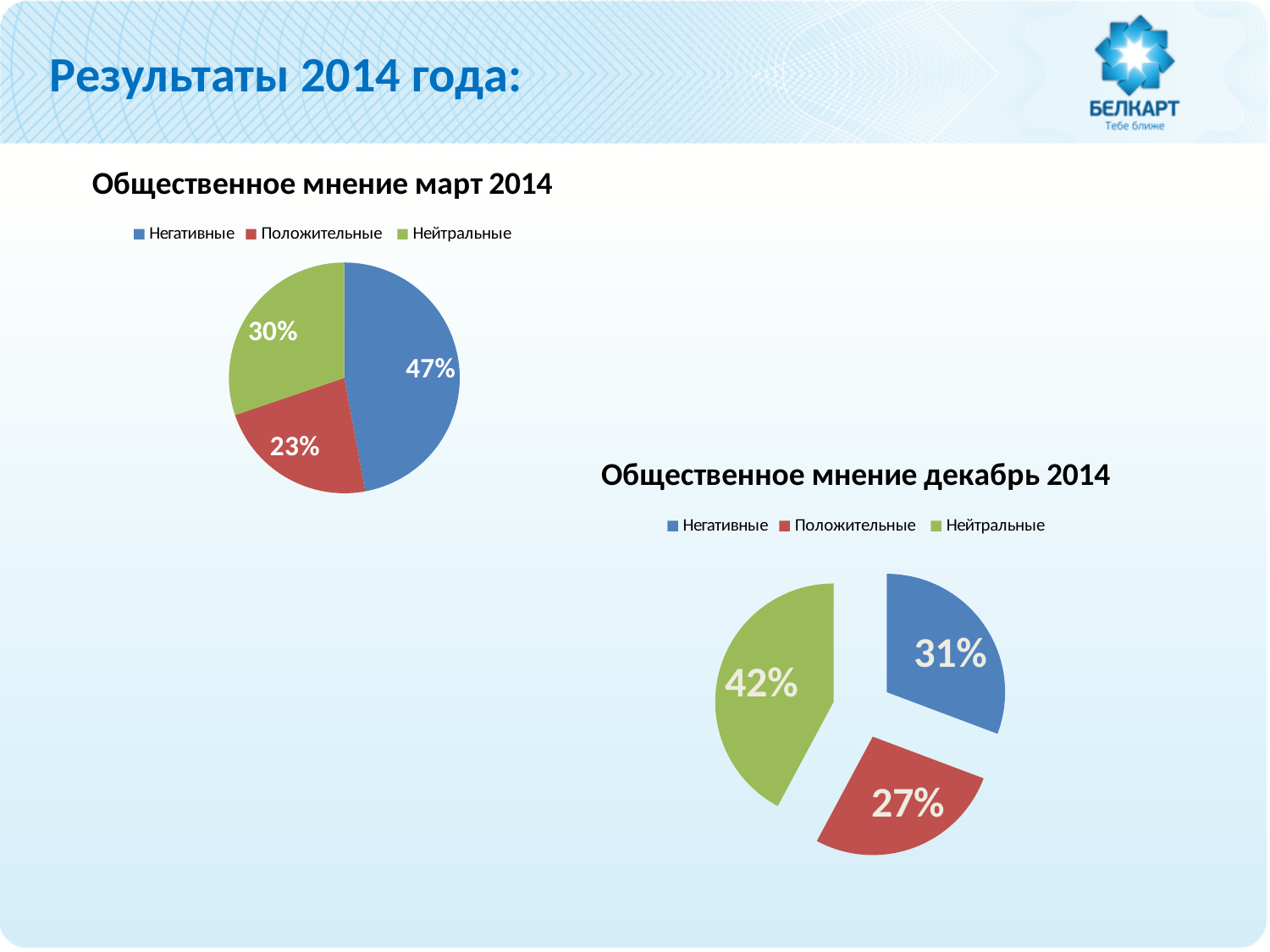
In the chart titled "Общественное мнение декабрь 2014", what colour is the Нейтральные slice? Green How many categories does the legend of the chart titled "Общественное мнение март 2014" list? 3 In the chart titled "Общественное мнение декабрь 2014", which is larger, Нейтральные or Негативные? Нейтральные In the chart titled "Общественное мнение март 2014", which category has the largest slice? Негативные In the chart titled "Общественное мнение декабрь 2014", what share is labelled for Положительные? 27% In the chart titled "Общественное мнение декабрь 2014", what share is labelled for Нейтральные? 42% In the chart titled "Общественное мнение март 2014", what is the difference between the Негативные and Положительные shares? 24% What is the title of the chart in the lower right of the slide? Общественное мнение декабрь 2014 In the chart titled "Общественное мнение март 2014", what share is labelled for Положительные? 23% What kind of chart is "Общественное мнение декабрь 2014"? Pie chart In the chart titled "Общественное мнение декабрь 2014", which category has the smallest slice? Положительные In the chart titled "Общественное мнение март 2014", what share is labelled for Негативные? 47%